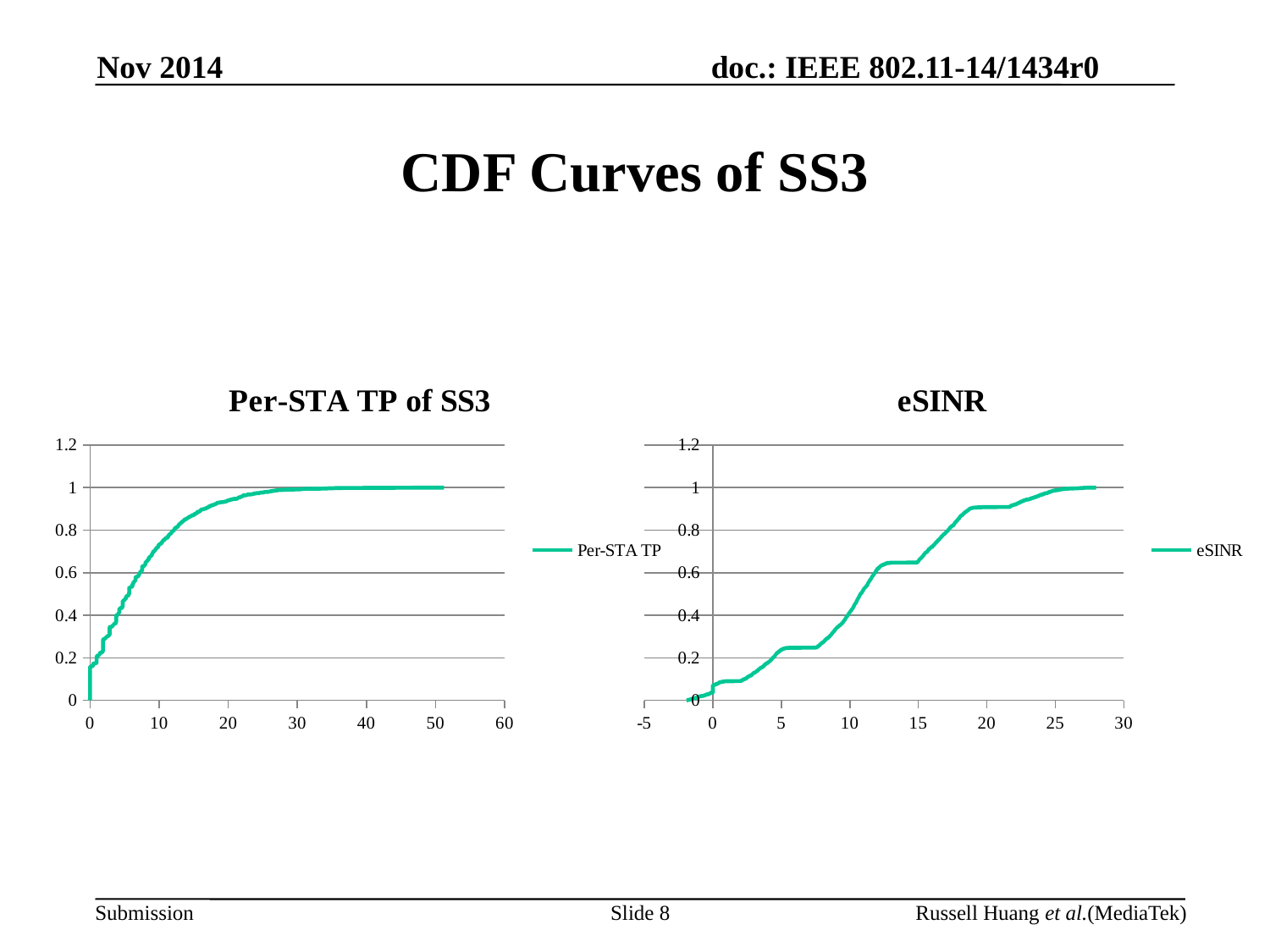
What kind of chart is the 'eSINR' chart? line chart What is the highest x-axis tick label on the 'Per-STA TP of SS3' chart? 60 In the 'eSINR' chart, is the value at x = 10 greater or less than 0.6? less In the 'eSINR' chart, is the value at x = 20 greater or less than 0.8? greater In the 'eSINR' chart, do the values rise or fall as you move along the x axis? rise How many series does the legend of the 'eSINR' chart list? 1 In the 'Per-STA TP of SS3' chart, is the value at x = 10 greater or less than 0.6? greater How many series does the legend of the 'Per-STA TP of SS3' chart list? 1 What kind of chart is the 'Per-STA TP of SS3' chart? line chart In the 'Per-STA TP of SS3' chart, do the values rise or fall as you move along the x axis? rise What is the legend entry shown on the 'eSINR' chart? eSINR